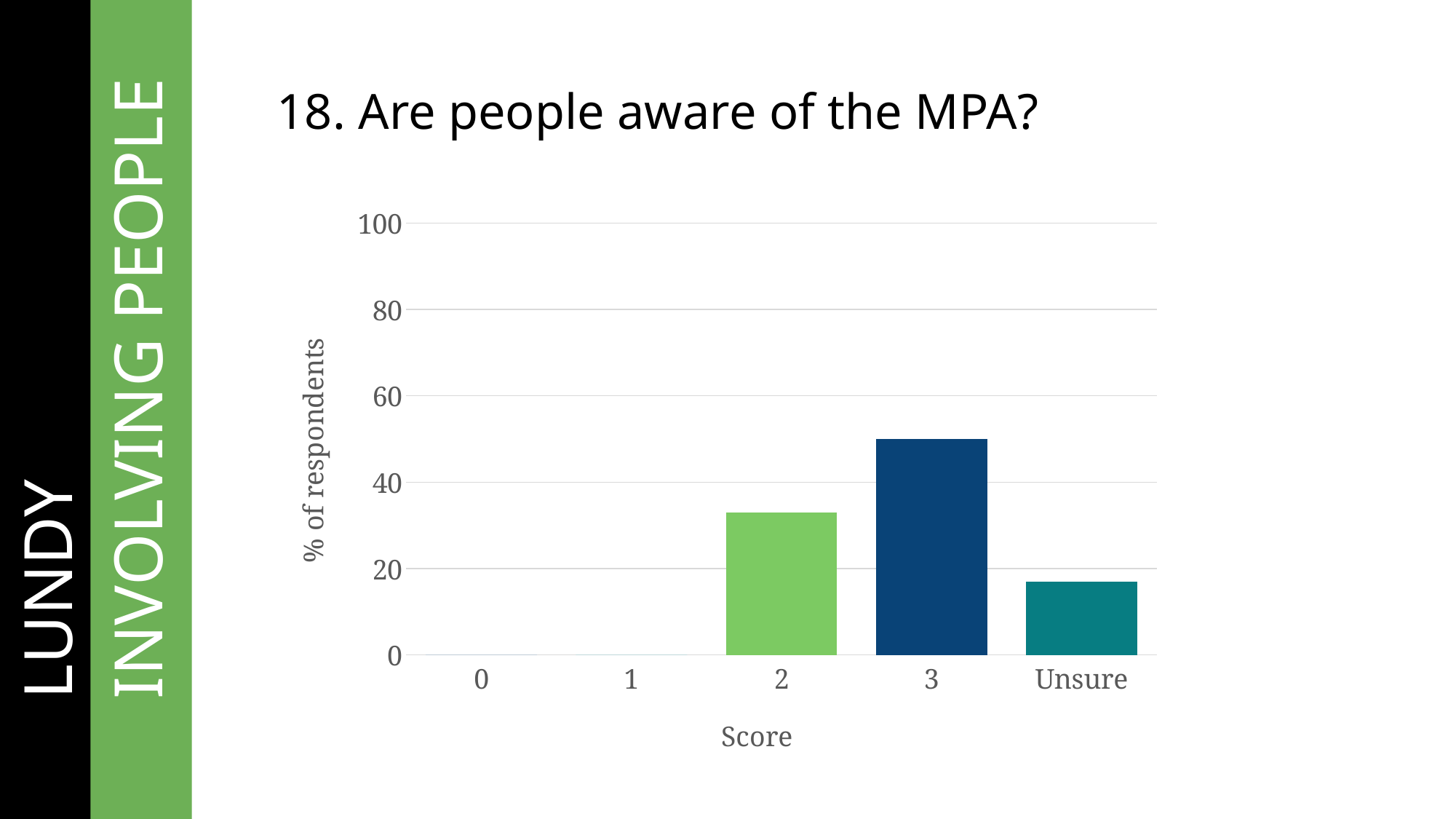
Is the value for score 3 greater or less than 40? greater Which score category has the highest percentage of respondents? 3 What is the label on the y axis of the chart? % of respondents How many categories are shown on the x axis of the chart? 5 Is the value for score 2 greater or less than 40? less Which is larger, the value for score 3 or the value for score 2? 3 Is the value for score 2 greater or less than 20? greater Which is larger, the value for score 2 or the value for Unsure? 2 What kind of chart is shown on the slide? bar chart What is the title of the chart on the slide? 18. Are people aware of the MPA?